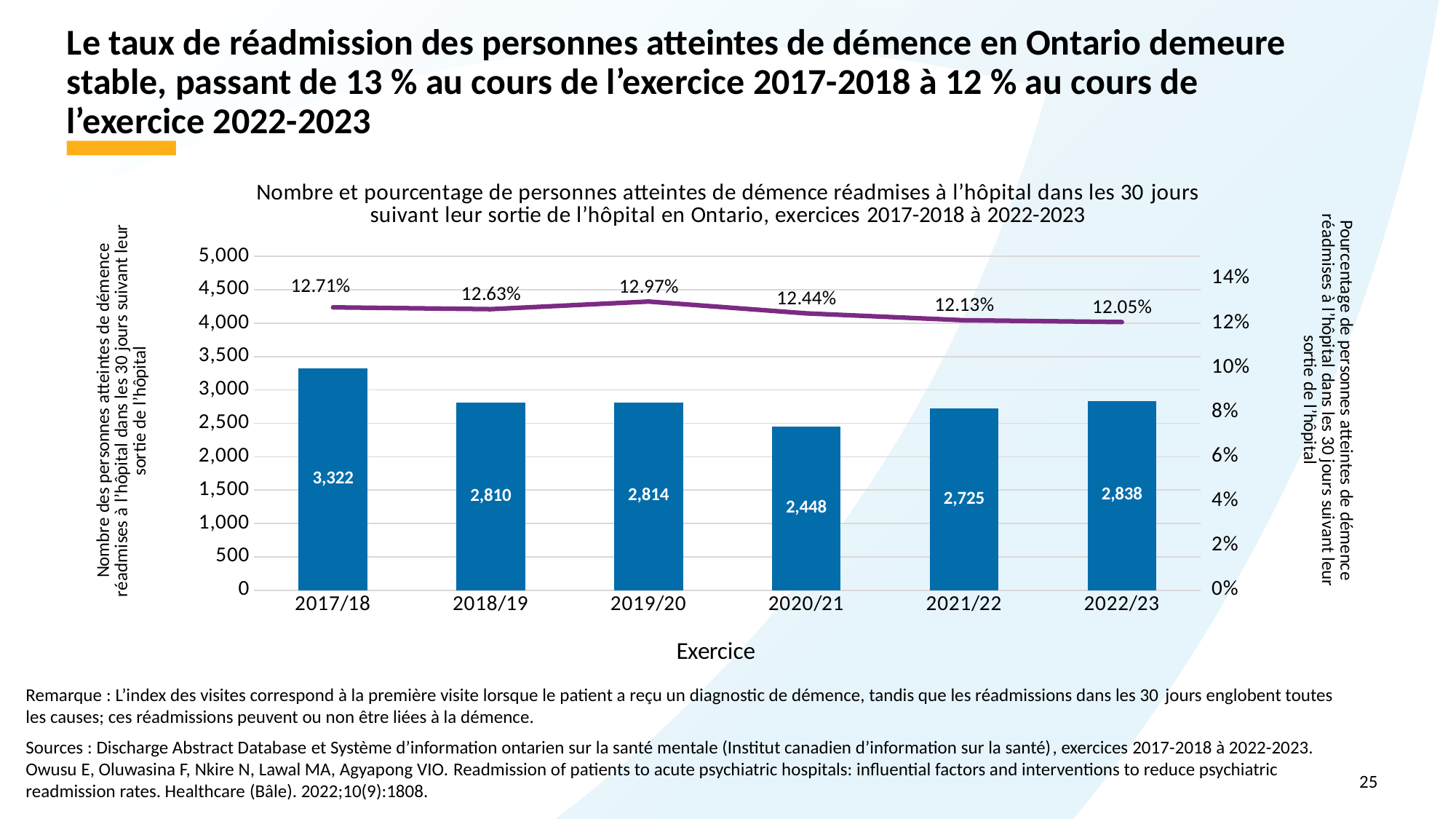
What kind of chart is shown on the slide? Combined bar and line chart What is the number of people with dementia readmitted within 30 days in 2017/18? 3,322 What is the readmission percentage shown for 2019/20? 12.97% Which fiscal year has the highest number of readmissions? 2017/18 Which is larger, the number of readmissions in 2021/22 or in 2022/23? 2022/23 Which fiscal year has the lowest readmission percentage on the line? 2022/23 What is the number of readmissions shown for 2020/21? 2,448 What is the label of the x axis? Exercice How many fiscal years are shown on the x axis? 6 Is the number of readmissions in 2020/21 greater or less than 2,500? less What is the difference in the number of readmissions between 2017/18 and 2022/23? 484 Which fiscal year has the lowest number of readmissions? 2020/21